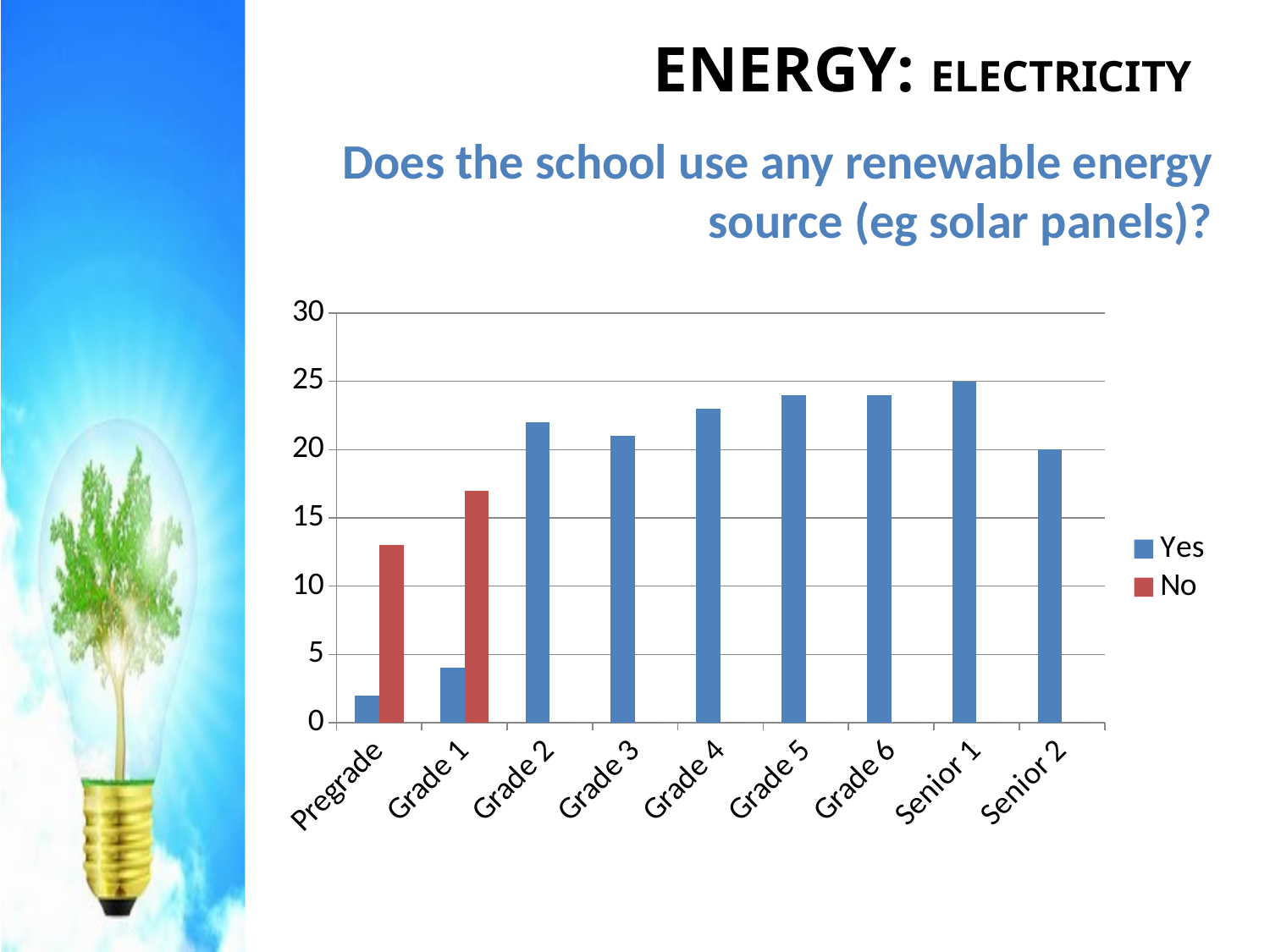
Which category has the lowest value for the Yes series? Pregrade Which two series are listed in the legend? Yes and No Is the No value for Pregrade greater or less than 10? greater How many series does the legend list? 2 What colour are the bars for the No series? red How many grade categories are shown on the x axis? 9 What kind of chart is shown on the slide? bar chart For Pregrade, which is larger, the Yes value or the No value? No Is the Yes value for Grade 5 greater or less than 20? greater For Grade 1, which is larger, the Yes value or the No value? No Is the Yes value for Grade 2 greater or less than 20? greater